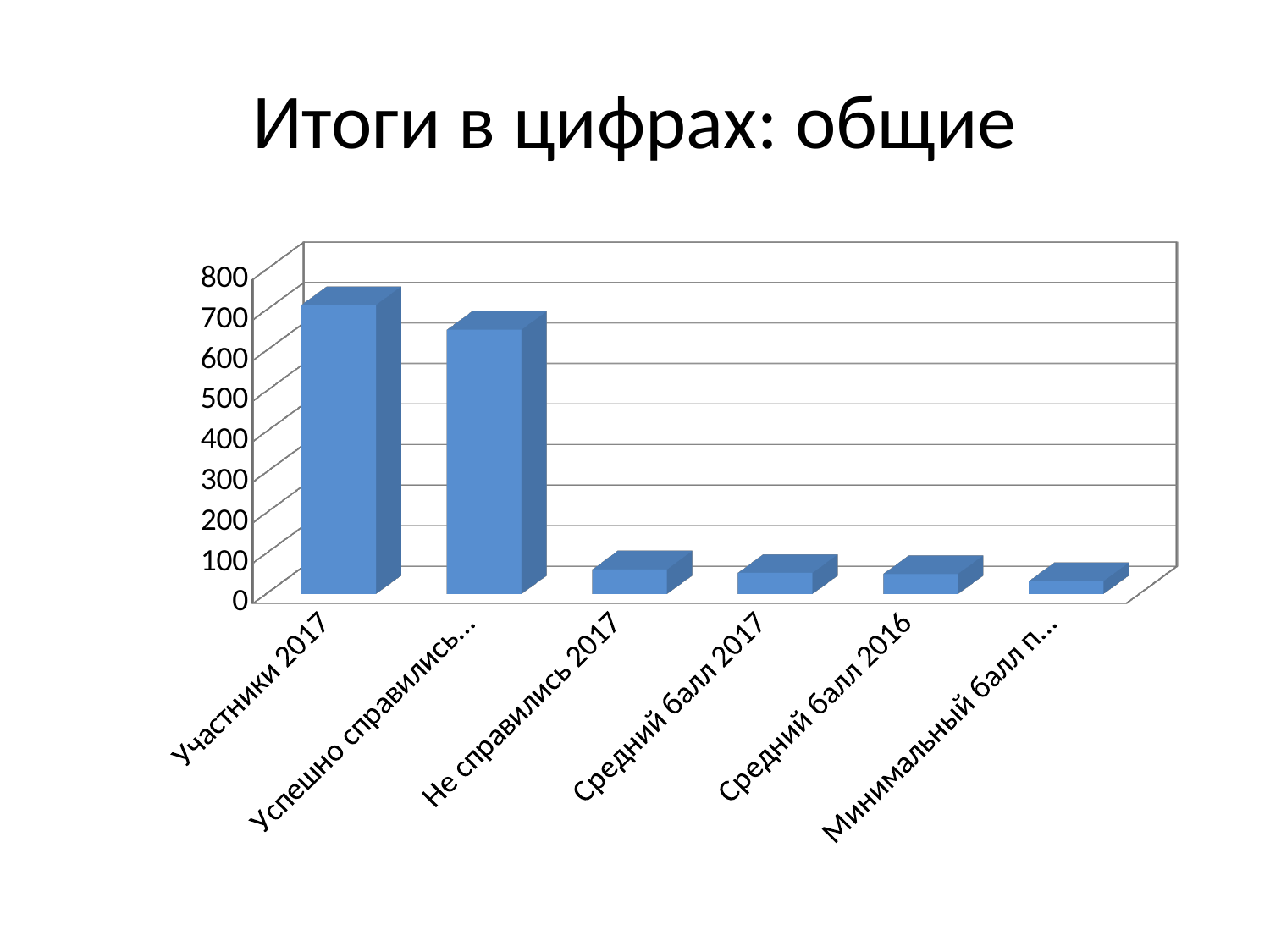
What is the title of the slide containing the chart? Итоги в цифрах: общие Which category has the highest bar in the chart? Участники 2017 Is the value for Не справились 2017 greater or less than 100? less Is the value for Средний балл 2016 greater or less than 100? less Is the value for Средний балл 2017 greater or less than 200? less What kind of chart is shown on the slide? bar chart What is the highest value shown on the vertical axis of the chart? 800 Which is larger, the value for Участники 2017 or the value for Не справились 2017? Участники 2017 How many categories are shown on the x axis of the chart? 6 Which is larger, the value for Средний балл 2017 or the value for Участники 2017? Участники 2017 Do the bar values generally rise or fall from left to right along the x axis? fall